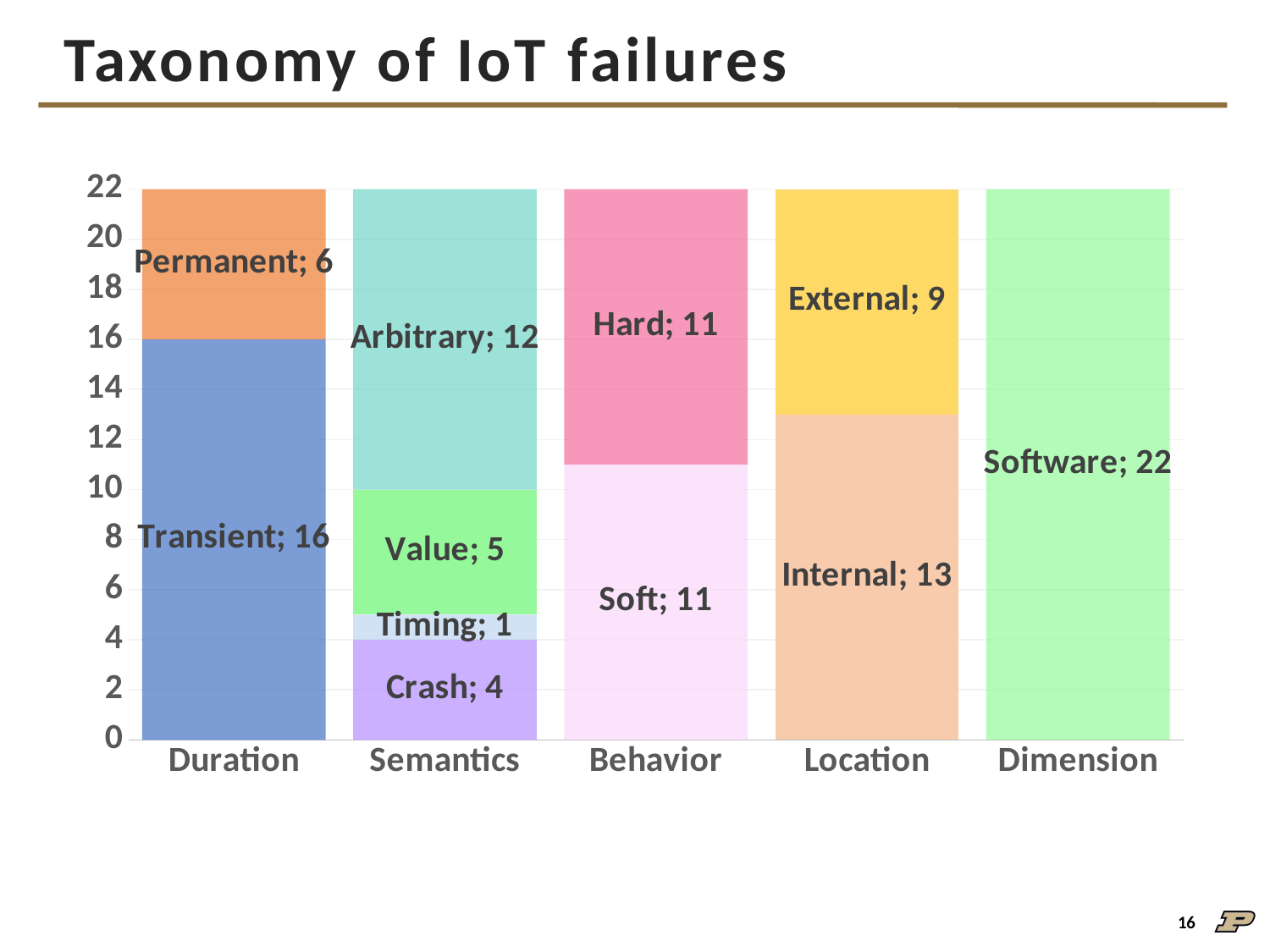
Which segment in the Semantics bar has the largest value? Arbitrary What kind of chart is shown on the slide? Stacked bar chart What is the value of the Transient segment in the Duration bar? 16 What is the difference between the Transient and Permanent values in the Duration bar? 10 Which is larger, the Value segment or the Crash segment in the Semantics bar? Value What is the total of the Semantics stacked bar? 22 Which segment in the Semantics bar has the smallest value? Timing What is the value of the Timing segment in the Semantics bar? 1 How many categories are shown on the x axis? 5 What is the value of the Arbitrary segment in the Semantics bar? 12 What is the difference between the Internal and External values in the Location bar? 4 What is the value of the External segment in the Location bar? 9